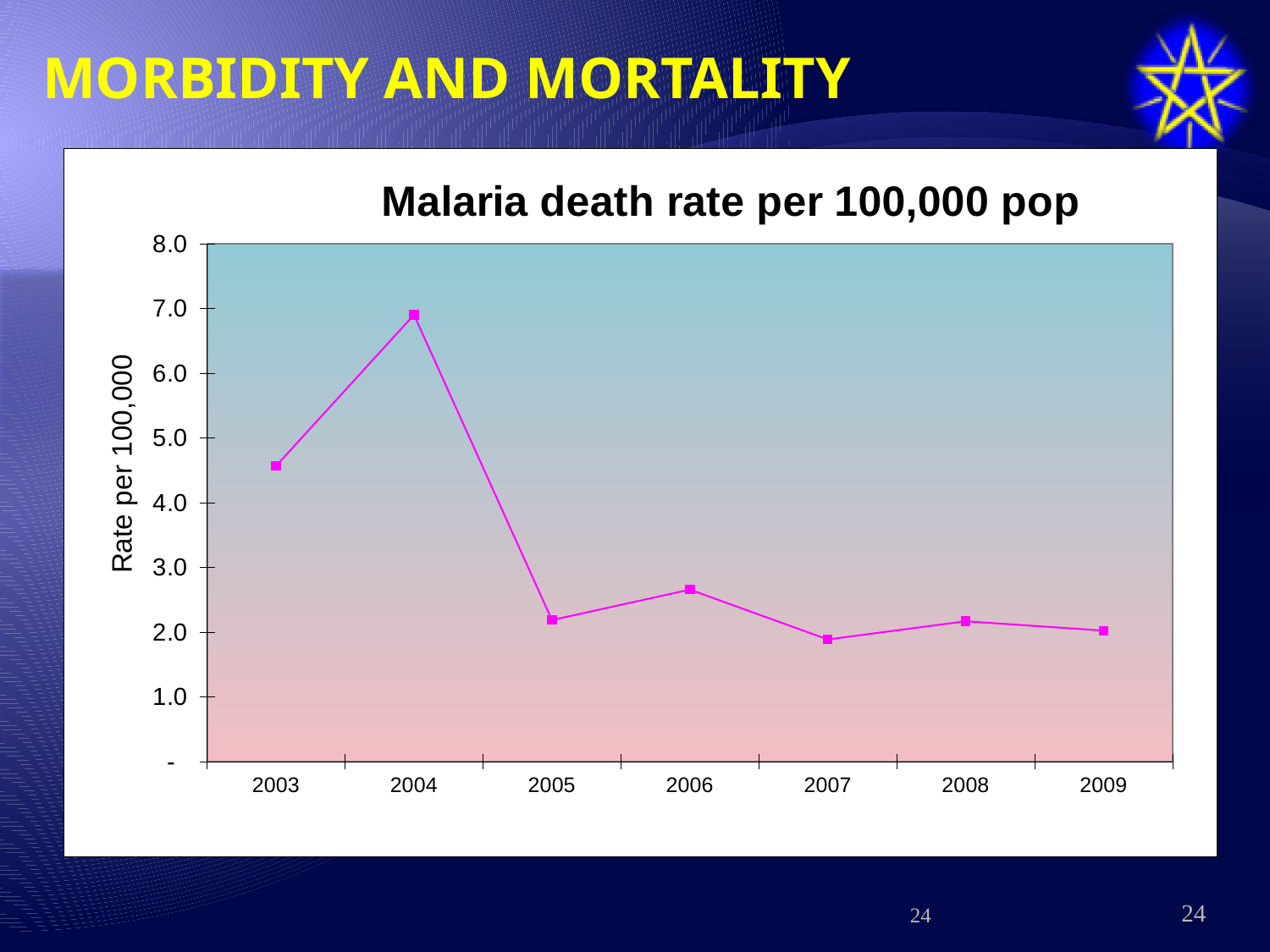
Did the malaria death rate rise or fall from 2004 to 2005? fall In which year was the malaria death rate lowest? 2007 What kind of chart is shown on the slide? line chart What is the label on the vertical axis of the chart? Rate per 100,000 Is the malaria death rate for 2004 greater or less than 6.0? greater Is the malaria death rate for 2003 greater or less than 4.0? greater What is the title of the chart? Malaria death rate per 100,000 pop Which year had a higher malaria death rate, 2003 or 2005? 2003 In which year was the malaria death rate highest? 2004 How many years are plotted on the x axis of the chart? 7 Is the malaria death rate for 2006 greater or less than 3.0? less